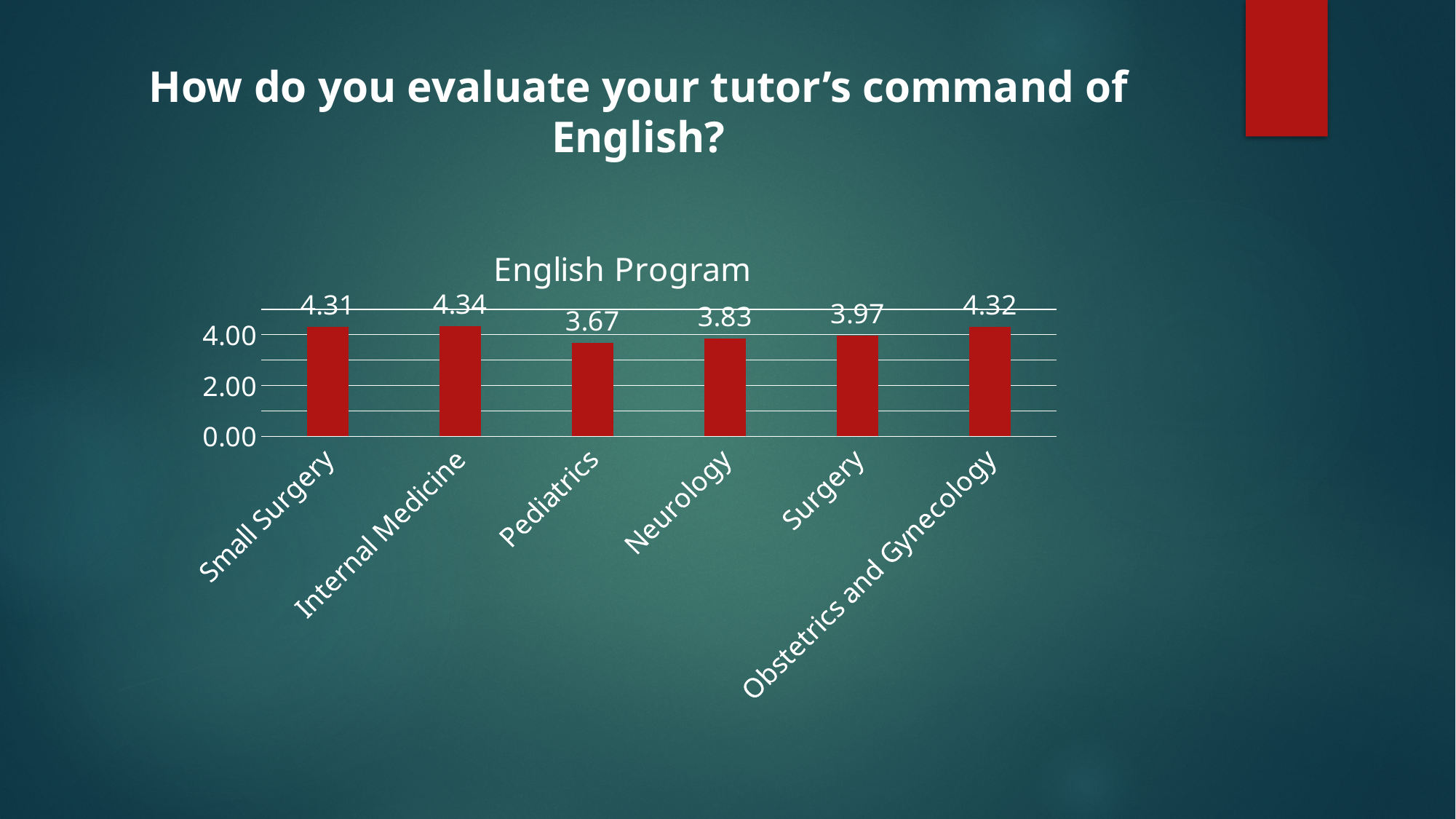
Which category has the highest value? Internal Medicine What kind of chart is shown on the slide? bar chart What is the difference between the values for Internal Medicine and Pediatrics? 0.67 What is the value for Small Surgery? 4.31 What is the value for Neurology? 3.83 Which category has the lowest value? Pediatrics How many categories are shown on the chart? 6 What is the value for Pediatrics? 3.67 What is the title of the chart? English Program Is the value for Pediatrics greater or less than 4.00? less What is the value for Obstetrics and Gynecology? 4.32 Which is larger, the value for Surgery or the value for Neurology? Surgery